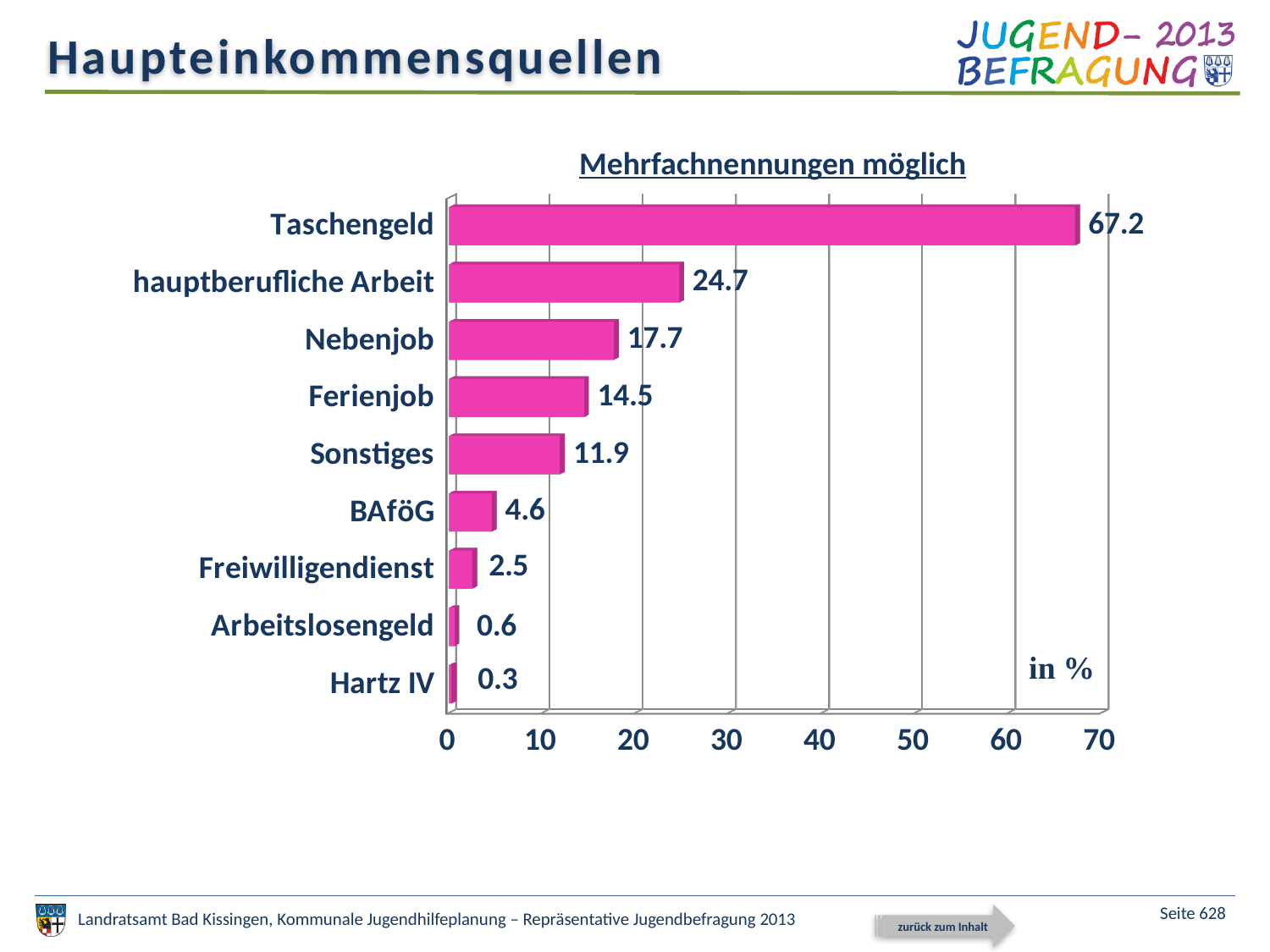
Which category has the lowest value? Hartz IV Which is larger, the value for Nebenjob or the value for Ferienjob? Nebenjob What is the value for Nebenjob? 17.7 Is the value for hauptberufliche Arbeit greater or less than 20? greater What is the difference between the values for Taschengeld and hauptberufliche Arbeit? 42.5 What is the difference between the values for Ferienjob and Sonstiges? 2.6 What kind of chart is shown on the slide? bar chart Which category has the highest value? Taschengeld What is the title shown above the chart? Mehrfachnennungen möglich What is the value for Taschengeld? 67.2 What is the value for BAföG? 4.6 How many categories are shown in the chart? 9